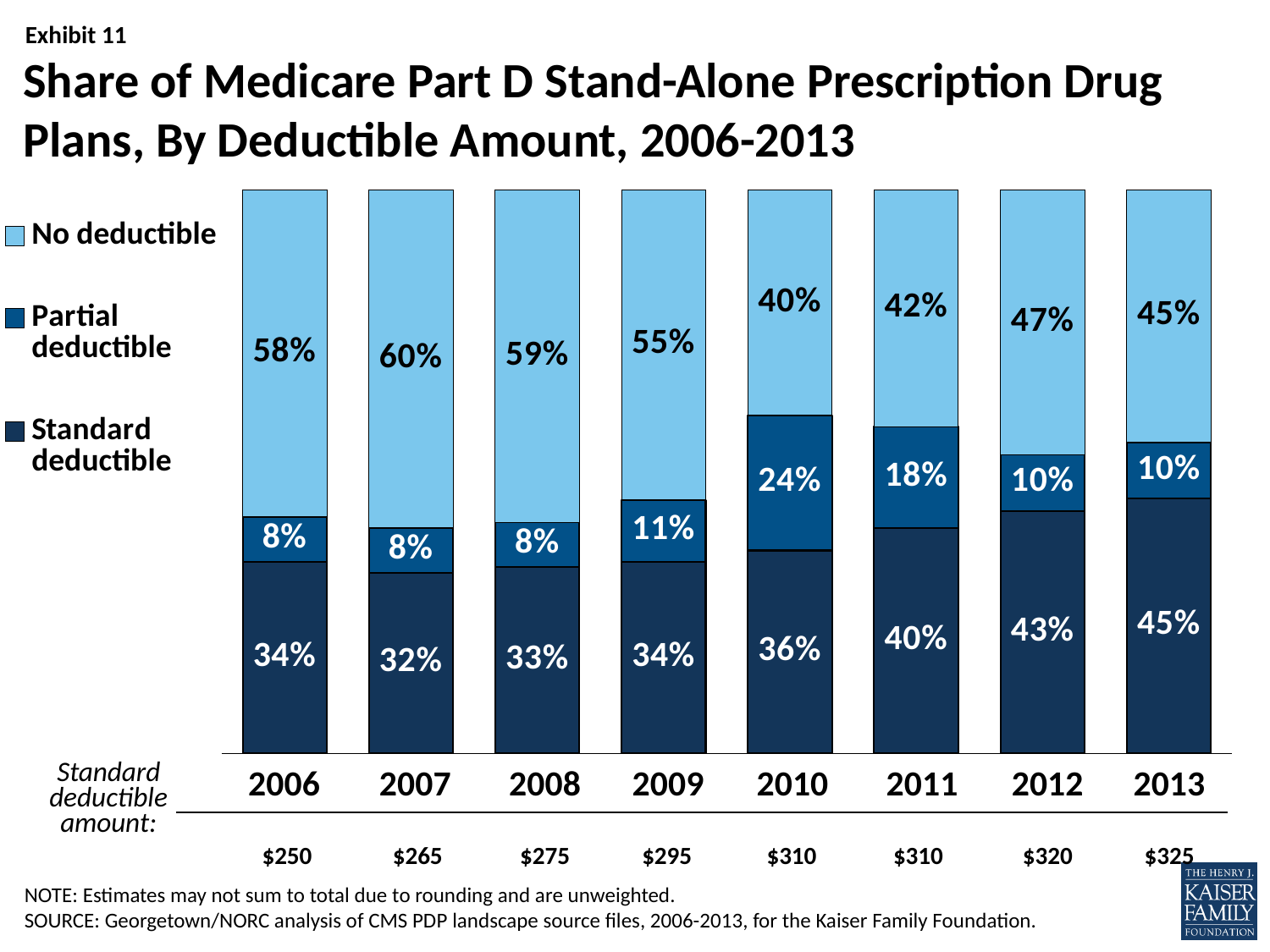
What share of plans had a standard deductible in 2013? 45% Which was larger in 2011: the share of plans with no deductible or the share with a standard deductible? No deductible Does the share of plans with a standard deductible rise or fall from 2009 to 2013? Rise What share of plans had a partial deductible in 2010? 24% In which year was the share of plans with a partial deductible highest? 2010 What was the standard deductible amount in 2009? $295 In which year was the share of plans with a standard deductible lowest? 2007 What kind of chart is shown on the slide? Stacked bar chart What share of plans had no deductible in 2006? 58% How much higher was the share of plans with no deductible in 2007 than in 2013? 15 percentage points How many years are shown on the x axis? 8 How many series does the legend list? 3